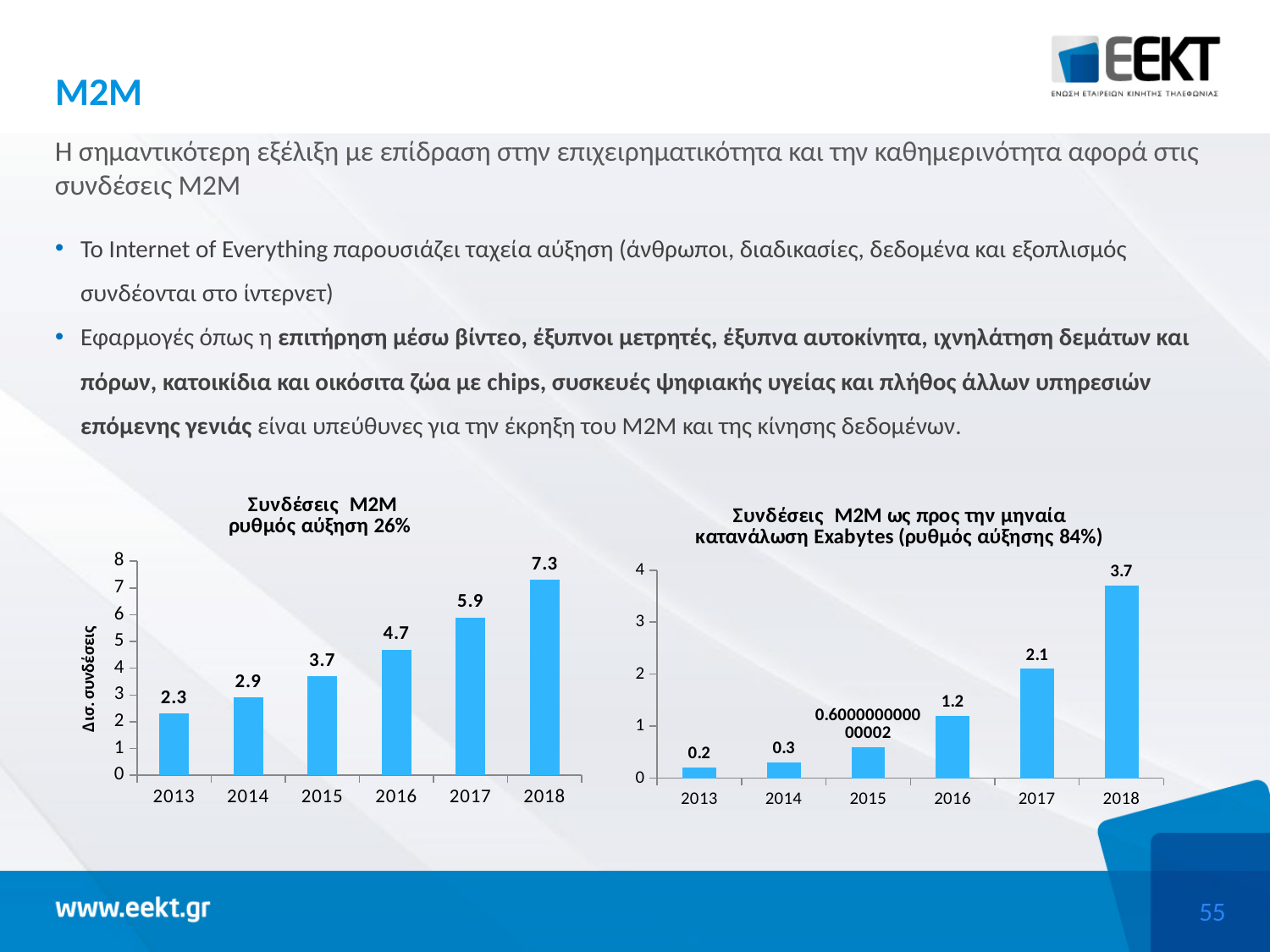
In the left chart (Συνδέσεις M2M ρυθμός αύξηση 26%), how many years are shown on the x axis? 6 In the left chart (Συνδέσεις M2M ρυθμός αύξηση 26%), do the values rise or fall from 2013 to 2018? rise In the right chart (Συνδέσεις M2M ως προς την μηναία κατανάλωση Exabytes), what is the value for 2017? 2.1 In the right chart (Συνδέσεις M2M ως προς την μηναία κατανάλωση Exabytes), which year has the highest value? 2018 In the left chart (Συνδέσεις M2M ρυθμός αύξηση 26%), what is the difference between the values for 2018 and 2013? 5.0 What kind of chart is the left chart (Συνδέσεις M2M ρυθμός αύξηση 26%)? bar chart In the right chart (Συνδέσεις M2M ως προς την μηναία κατανάλωση Exabytes), what is the difference between the values for 2018 and 2017? 1.6 In the left chart (Συνδέσεις M2M ρυθμός αύξηση 26%), what is the value for 2018? 7.3 In the right chart (Συνδέσεις M2M ως προς την μηναία κατανάλωση Exabytes), which is larger, the value for 2016 or the value for 2017? 2017 In the right chart (Συνδέσεις M2M ως προς την μηναία κατανάλωση Exabytes), what is the value for 2014? 0.3 In the left chart (Συνδέσεις M2M ρυθμός αύξηση 26%), what is the value for 2015? 3.7 In the left chart (Συνδέσεις M2M ρυθμός αύξηση 26%), which year has the lowest value? 2013